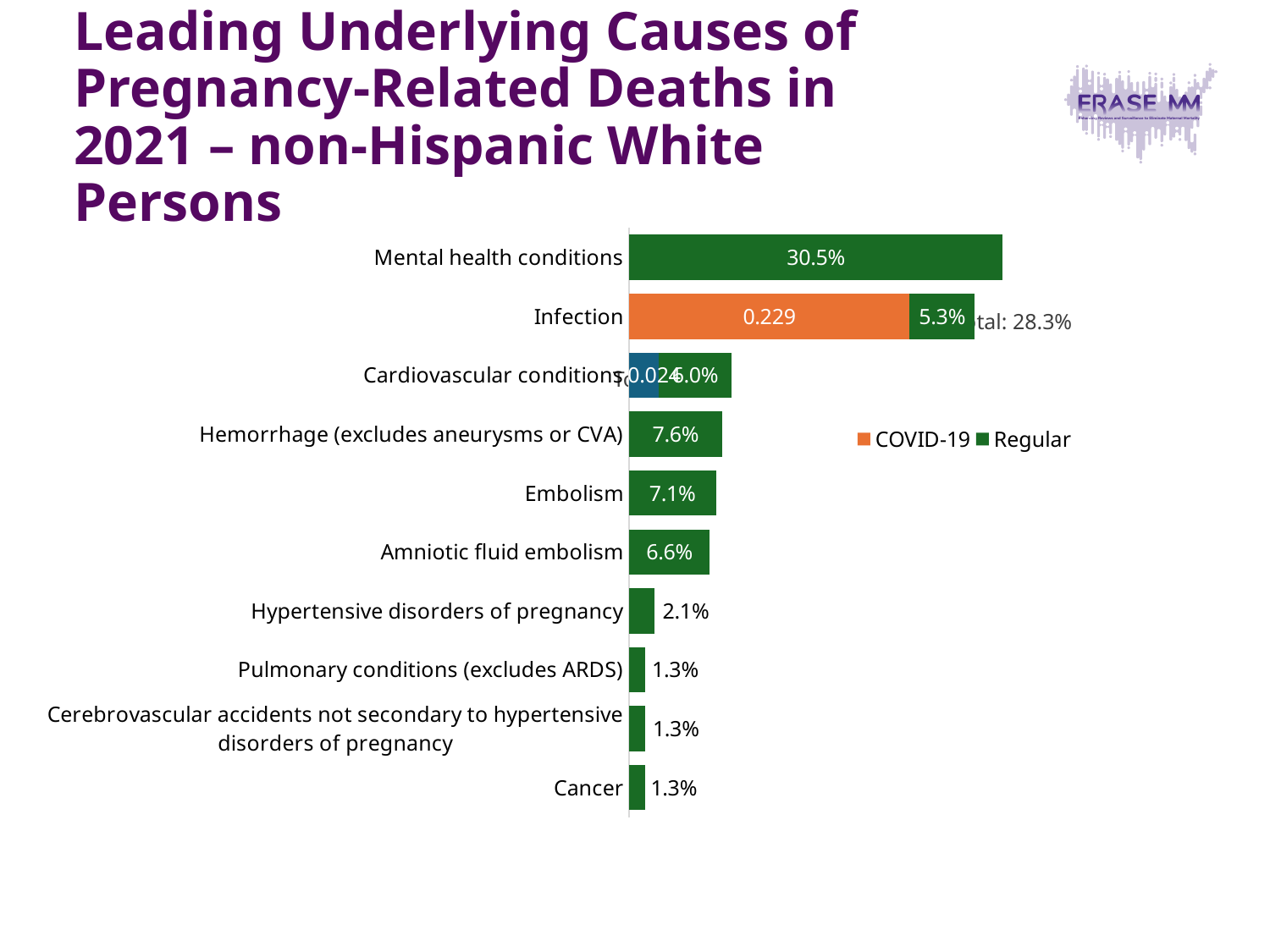
What is the value for Hypertensive disorders of pregnancy? 2.1% What is the value for Embolism? 7.1% What kind of chart is shown on the slide? Bar chart What is the value for Hemorrhage (excludes aneurysms or CVA)? 7.6% Which category has the highest value? Mental health conditions Which is larger, the value for Embolism or the value for Amniotic fluid embolism? Embolism How many categories are shown on the chart? 10 What is the value for Amniotic fluid embolism? 6.6% What is the difference between the values for Hemorrhage (excludes aneurysms or CVA) and Embolism? 0.5% What is the Regular (non-COVID-19) value for Infection? 5.3% What is the value for Mental health conditions? 30.5% How many series does the legend list? 2